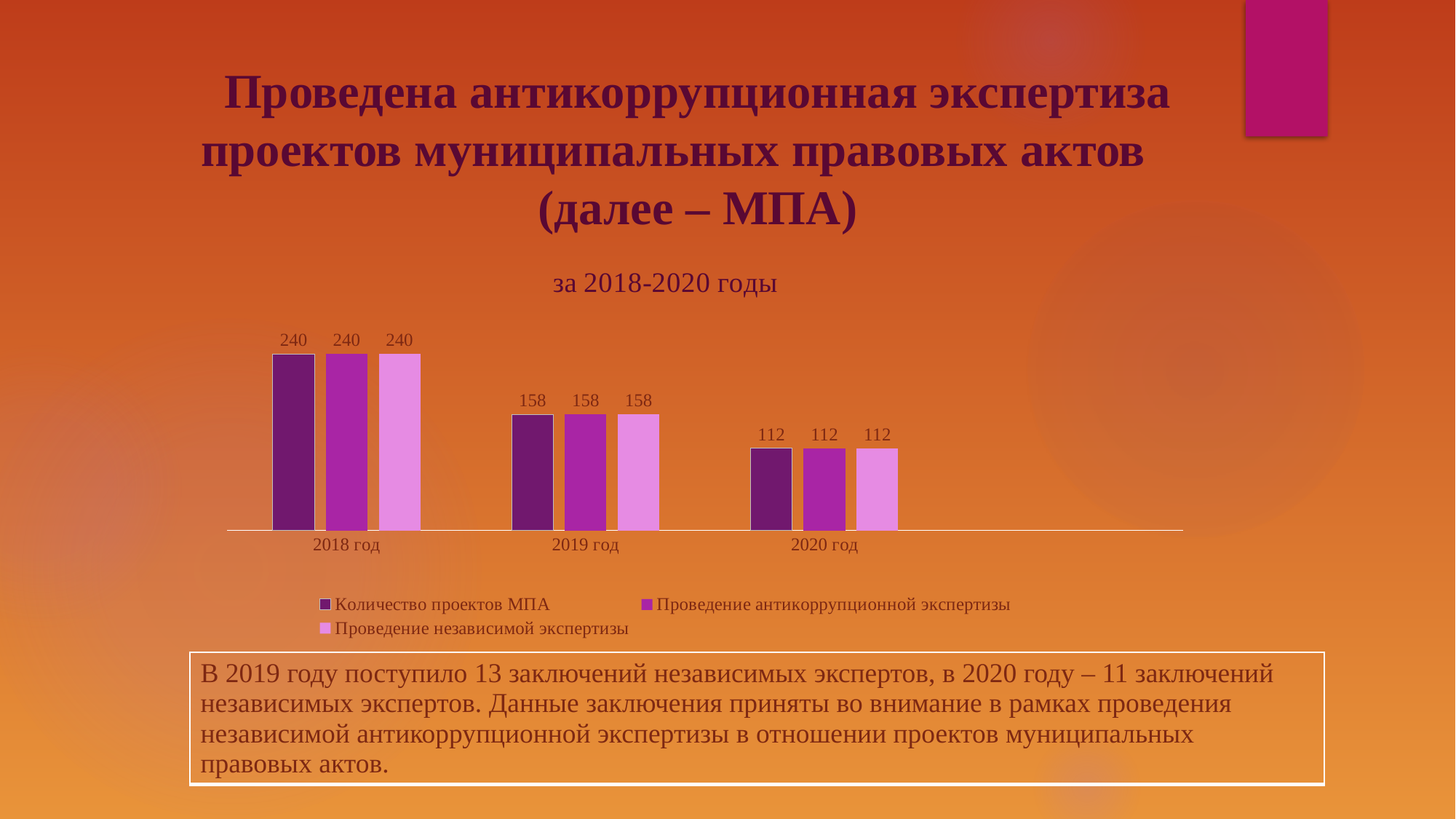
Do the values for "Количество проектов МПА" rise or fall from 2018 год to 2020 год? fall Which year has the lowest value for "Проведение независимой экспертизы"? 2020 год What is the value of "Проведение независимой экспертизы" for 2020 год? 112 What kind of chart is shown on the slide? bar chart What is the difference between the "Количество проектов МПА" values for 2018 год and 2020 год? 128 What is the difference between the "Проведение антикоррупционной экспертизы" values for 2018 год and 2019 год? 82 How many series does the legend list? 3 Which is larger: "Количество проектов МПА" for 2019 год or for 2020 год? 2019 год Which year has the highest value for "Количество проектов МПА"? 2018 год How many year categories are shown on the x axis? 3 What is the value of "Проведение антикоррупционной экспертизы" for 2019 год? 158 What is the value of "Количество проектов МПА" for 2018 год? 240